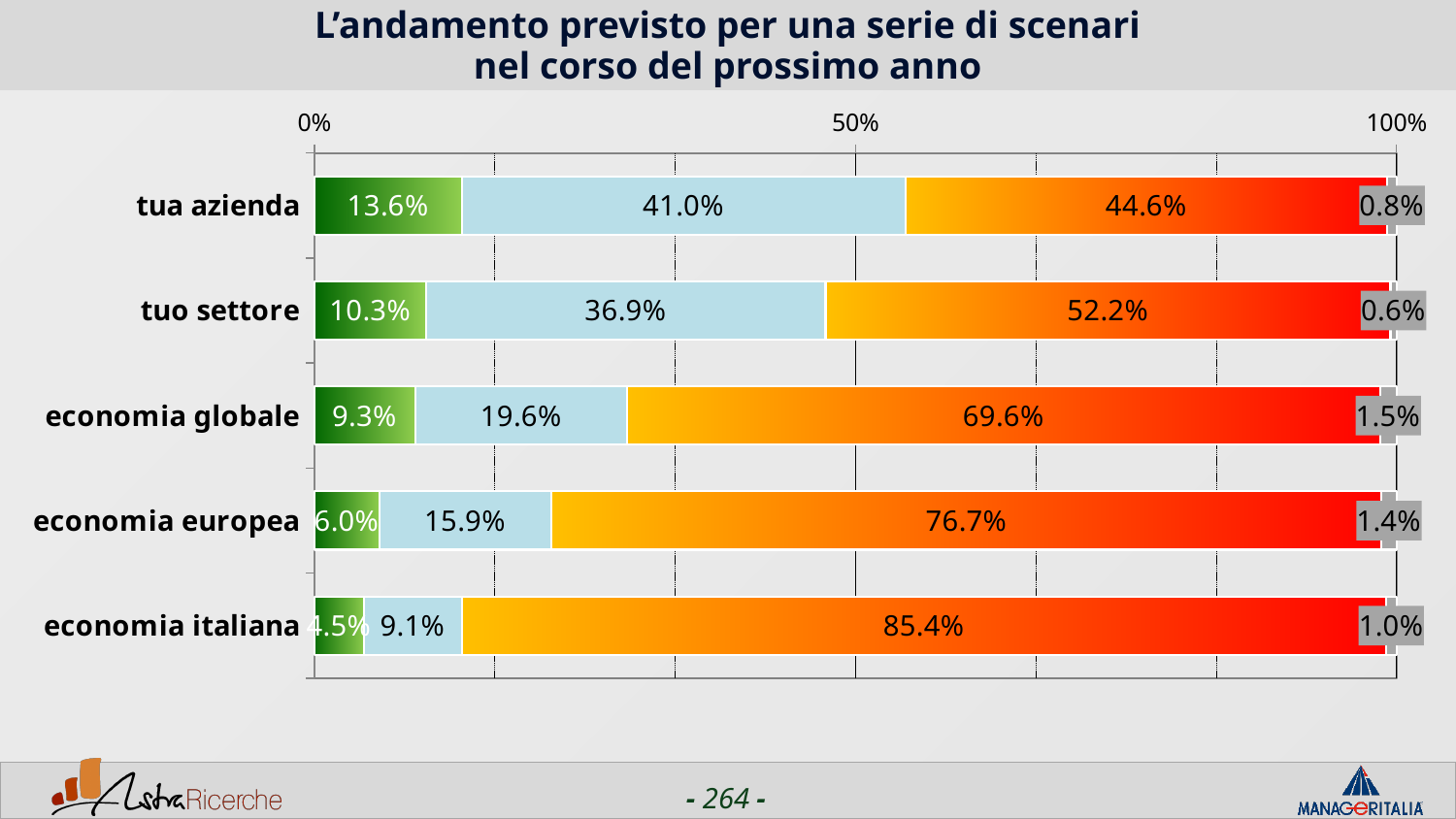
Is the orange segment value for 'tuo settore' greater or less than 50%? greater Which category has the smallest green segment? economia italiana What is the value of the grey segment for 'economia globale'? 1.5% What is the title of the chart? L'andamento previsto per una serie di scenari nel corso del prossimo anno What is the value of the light blue segment for 'tuo settore'? 36.9% What is the value of the green segment for 'tua azienda'? 13.6% What is the value of the orange segment for 'economia italiana'? 85.4% What is the difference between the orange segment values for 'economia europea' and 'economia globale'? 7.1% Which category has the largest orange segment? economia italiana What type of chart is shown on the slide? stacked bar chart How many categories (scenarios) are shown on the chart? 5 Which is larger: the light blue segment for 'tua azienda' or the light blue segment for 'tuo settore'? tua azienda